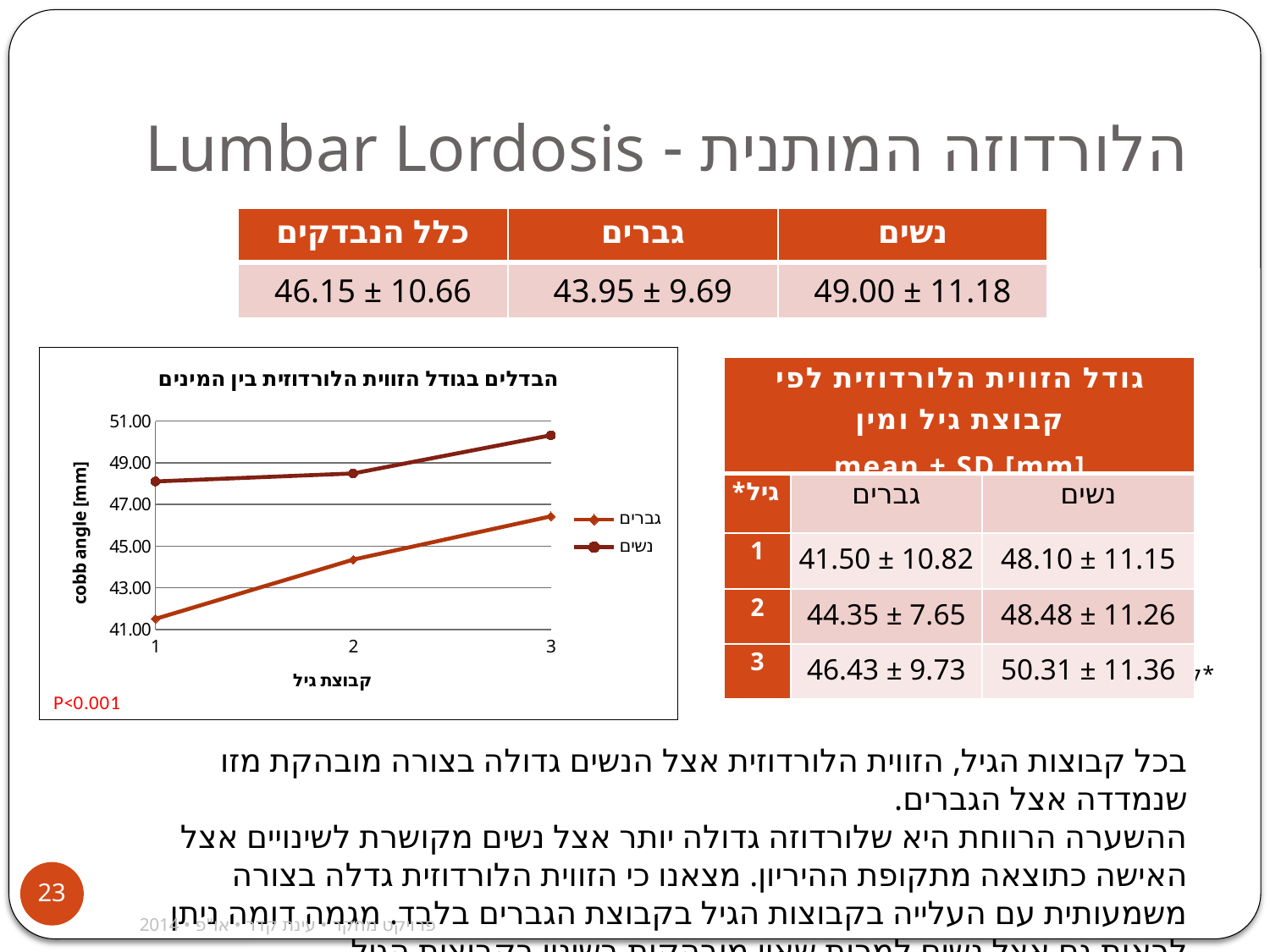
Is the value for נשים at age group 3 greater or less than 49.00? greater How many series does the chart legend list? 2 Do the values for גברים rise or fall from age group 1 to age group 3? rise What is the label of the chart's y axis? cobb angle [mm] Which series has the higher value at age group 3, גברים or נשים? נשים Which series has the higher value at age group 1, גברים or נשים? נשים What is the label of the chart's x axis? קבוצת גיל What kind of chart is shown on the slide? line chart Do the values for נשים rise or fall from age group 1 to age group 3? rise Is the value for גברים at age group 1 greater or less than 43.00? less Is the value for גברים at age group 2 greater or less than 43.00? greater How many age groups are plotted along the x axis of the chart? 3